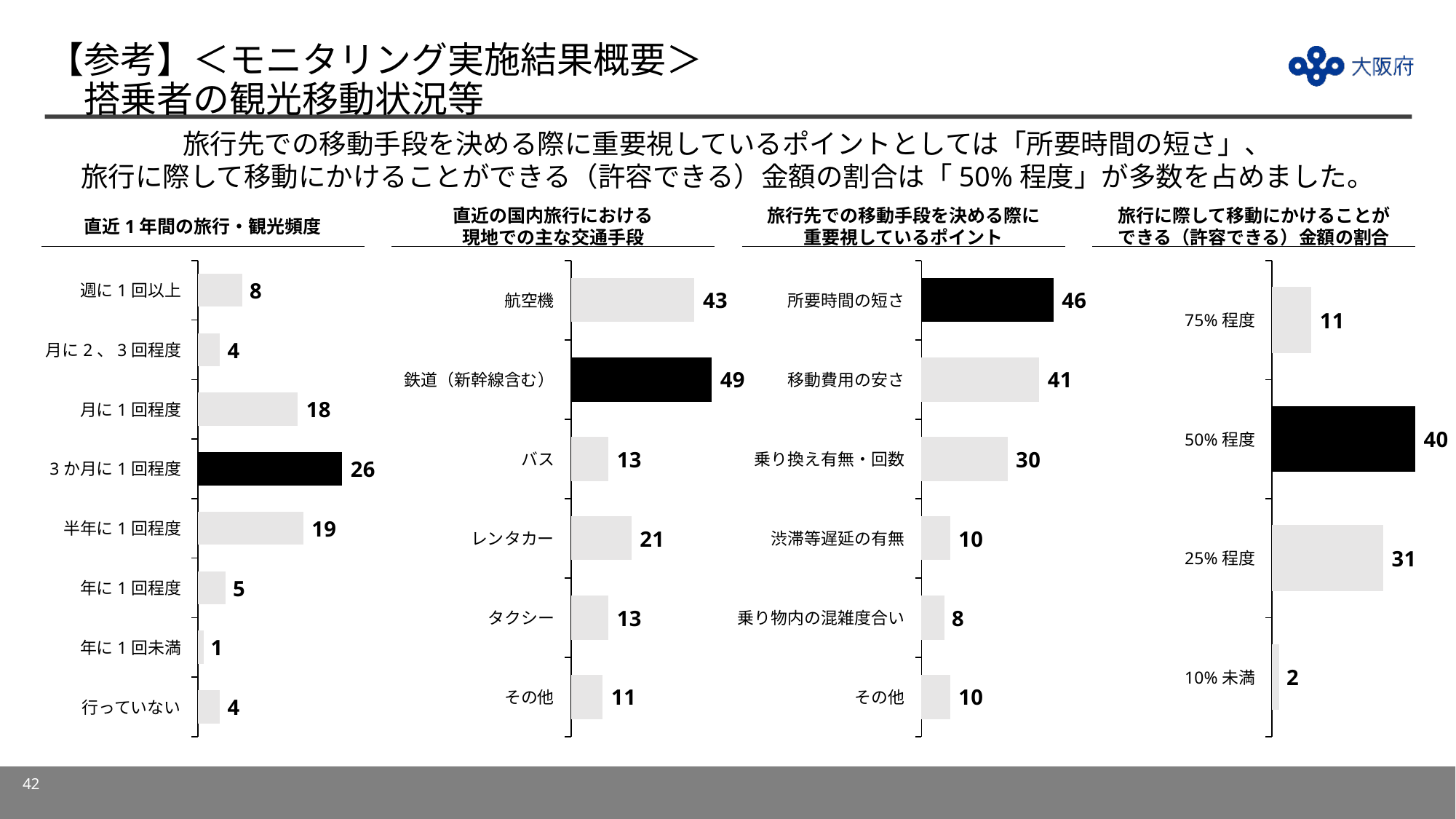
In the chart titled 直近1年間の旅行・観光頻度, what is the value for 3か月に1回程度? 26 In the chart titled 旅行先での移動手段を決める際に重要視しているポイント, what is the value for 乗り換え有無・回数? 30 In the chart titled 直近の国内旅行における現地での主な交通手段, what is the value for レンタカー? 21 In the chart titled 直近の国内旅行における現地での主な交通手段, which category has the highest value? 鉄道（新幹線含む） In the chart titled 直近1年間の旅行・観光頻度, which category has the lowest value? 年に1回未満 In the chart titled 直近の国内旅行における現地での主な交通手段, what is the difference between 鉄道（新幹線含む） and 航空機? 6 In the chart titled 旅行先での移動手段を決める際に重要視しているポイント, which is larger, 所要時間の短さ or 移動費用の安さ? 所要時間の短さ In the chart titled 旅行に際して移動にかけることができる（許容できる）金額の割合, what is the difference between 50%程度 and 75%程度? 29 In the chart titled 旅行に際して移動にかけることができる（許容できる）金額の割合, what is the value for 25%程度? 31 In the chart titled 直近1年間の旅行・観光頻度, how many categories are shown? 8 What kind of chart is the chart titled 旅行に際して移動にかけることができる（許容できる）金額の割合? bar chart In the chart titled 旅行先での移動手段を決める際に重要視しているポイント, which category has the lowest value? 乗り物内の混雑度合い